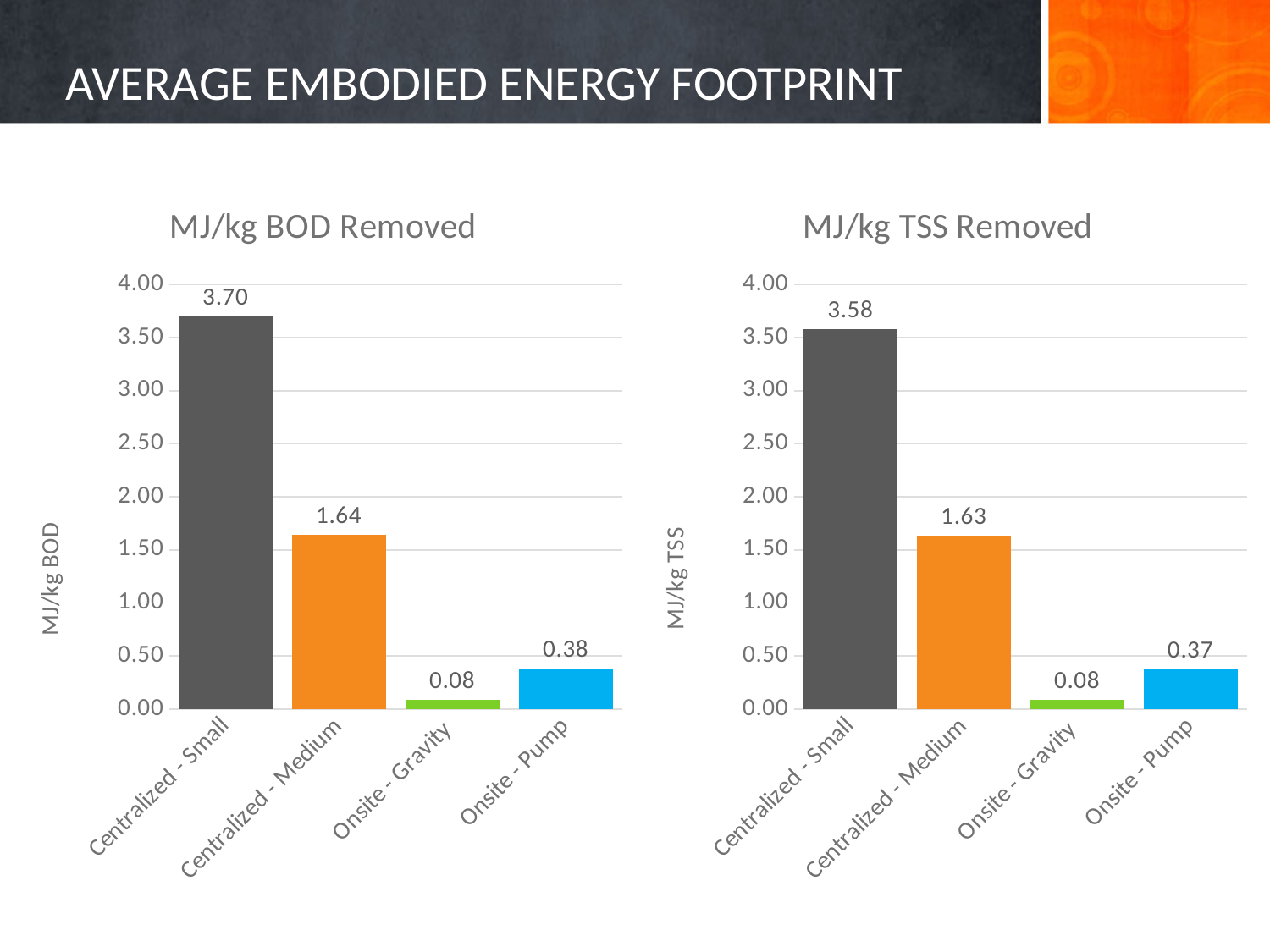
In the MJ/kg TSS Removed chart, what is the difference between Onsite - Pump and Onsite - Gravity? 0.29 How many categories are shown in the MJ/kg BOD Removed chart? 4 What is the y-axis label of the MJ/kg BOD Removed chart? MJ/kg BOD In the MJ/kg BOD Removed chart, which is larger, Onsite - Gravity or Onsite - Pump? Onsite - Pump In the MJ/kg TSS Removed chart, what is the value for Onsite - Pump? 0.37 What kind of chart is the MJ/kg TSS Removed chart? bar chart In the MJ/kg BOD Removed chart, what is the difference between Centralized - Small and Centralized - Medium? 2.06 In the MJ/kg TSS Removed chart, which category has the lowest value? Onsite - Gravity In the MJ/kg BOD Removed chart, which category has the highest value? Centralized - Small In the MJ/kg TSS Removed chart, is the value for Centralized - Small greater or less than 3.00? greater In the MJ/kg BOD Removed chart, what is the value for Centralized - Small? 3.70 In the MJ/kg TSS Removed chart, what is the value for Centralized - Medium? 1.63